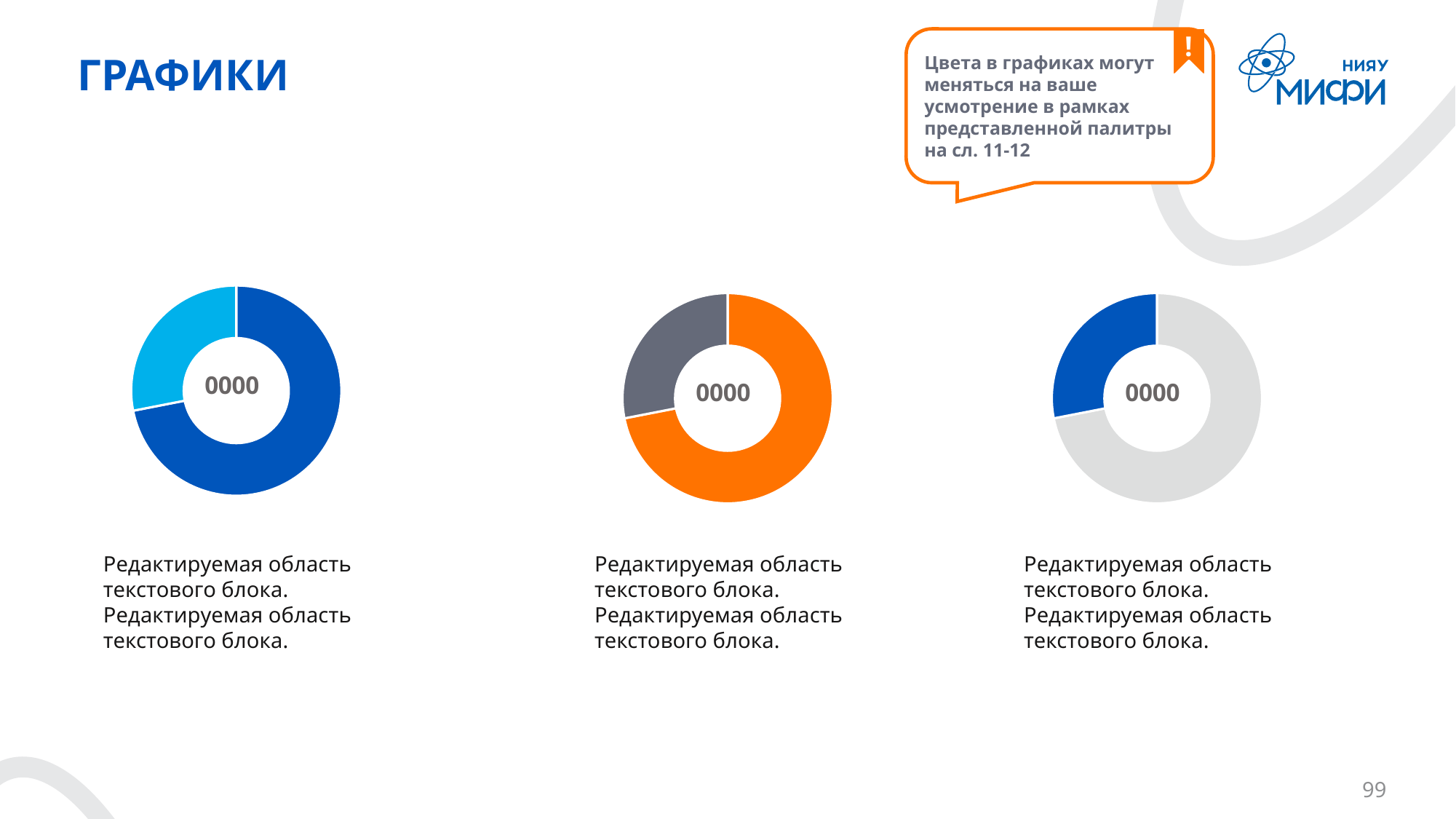
What colour is the larger slice of the middle doughnut chart? orange In the left doughnut chart, which slice is larger, the dark blue one or the light blue one? dark blue What kind of chart is the left chart on the slide? doughnut (pie) chart How many slices does the middle doughnut chart have? 2 What kind of chart is the middle chart on the slide? doughnut (pie) chart How many charts are shown on the slide? 3 In the right doughnut chart, which slice is larger, the blue one or the light grey one? light grey What text is printed in the centre of the left doughnut chart? 0000 In the middle doughnut chart, which slice is larger, the orange one or the grey one? orange How many slices does the right doughnut chart have? 2